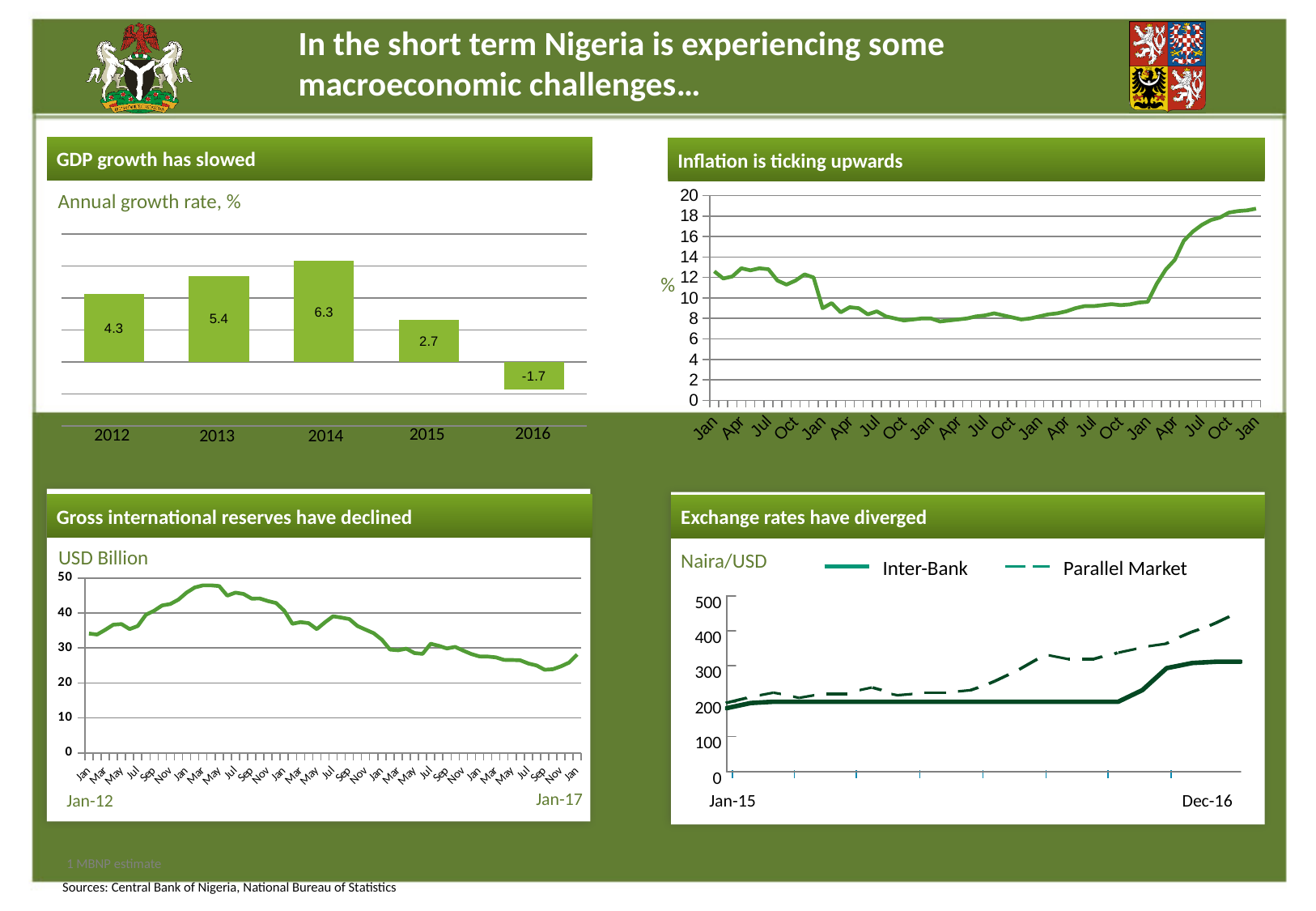
On the 'GDP growth has slowed' chart, how many years are shown? 5 On the 'Inflation is ticking upwards' chart, is the value at the final Jan point greater or less than 16? greater On the 'GDP growth has slowed' chart, what is the annual growth rate for 2014? 6.3 On the 'GDP growth has slowed' chart, what is the difference between the growth rates for 2014 and 2015? 3.6 What kind of chart is the 'GDP growth has slowed' chart? Bar chart On the 'Gross international reserves have declined' chart, is the peak value in 2013 greater or less than 40? greater On the 'Exchange rates have diverged' chart, how many series does the legend list? 2 On the 'GDP growth has slowed' chart, which year has the highest growth rate? 2014 On the 'Exchange rates have diverged' chart, which series is higher at Dec-16, Inter-Bank or Parallel Market? Parallel Market On the 'Exchange rates have diverged' chart, is the Parallel Market value at Dec-16 greater or less than 400? greater On the 'GDP growth has slowed' chart, which year has the lowest growth rate? 2016 On the 'GDP growth has slowed' chart, what is the annual growth rate for 2016? -1.7